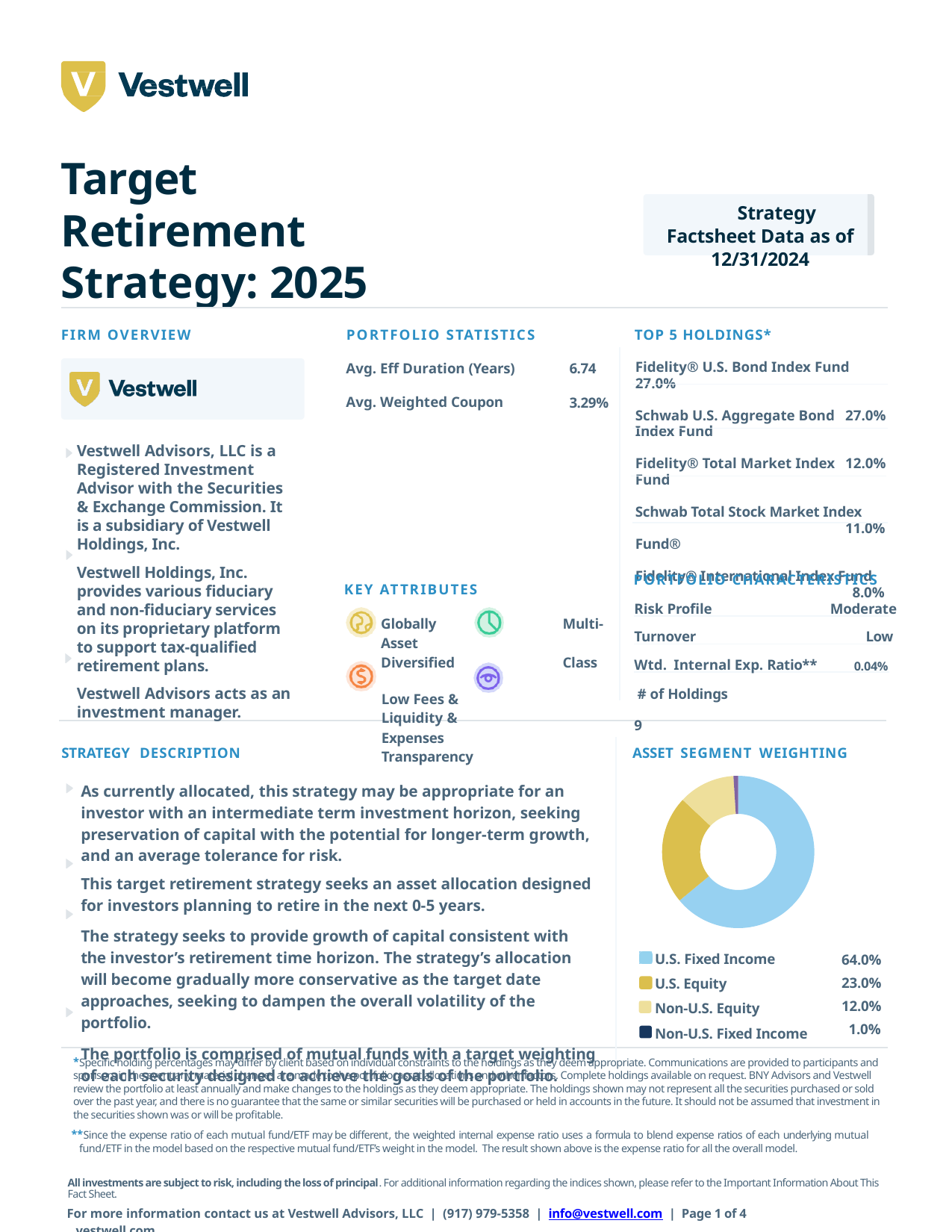
Which segment has the smallest share in the Asset Segment Weighting chart? Non-U.S. Fixed Income How many segments are shown in the Asset Segment Weighting chart? 4 What kind of chart is shown under Asset Segment Weighting? Donut (pie) chart In the Asset Segment Weighting chart, what is the weighting for U.S. Equity? 23.0% What colour represents U.S. Fixed Income in the Asset Segment Weighting chart? Light blue Which segment has the largest share in the Asset Segment Weighting chart? U.S. Fixed Income In the Asset Segment Weighting chart, what is the combined weighting of U.S. Equity and Non-U.S. Equity? 35.0% In the Asset Segment Weighting chart, what is the difference between the U.S. Fixed Income and U.S. Equity weightings? 41.0% In the Asset Segment Weighting chart, which is larger: U.S. Equity or Non-U.S. Equity? U.S. Equity In the Asset Segment Weighting chart, what is the weighting for Non-U.S. Fixed Income? 1.0% In the Asset Segment Weighting chart, what is the weighting for Non-U.S. Equity? 12.0% In the Asset Segment Weighting chart, what is the weighting for U.S. Fixed Income? 64.0%